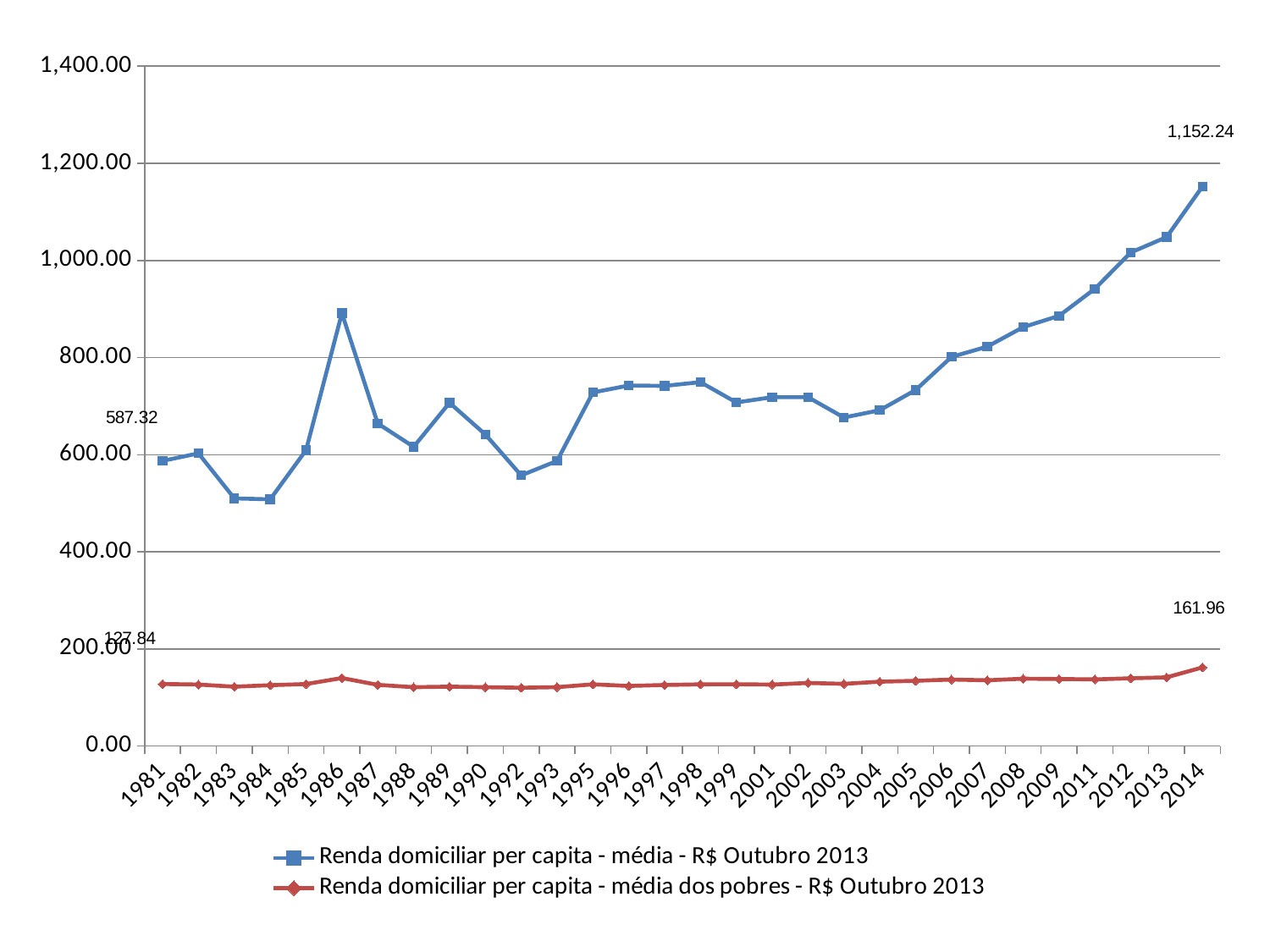
How many series does the legend list? 2 What is the value of the 'Renda domiciliar per capita - média - R$ Outubro 2013' series in 2014? 1,152.24 Which year has the larger value for the 'Renda domiciliar per capita - média - R$ Outubro 2013' series, 1986 or 1987? 1986 What is the value of the 'Renda domiciliar per capita - média - R$ Outubro 2013' series in 1981? 587.32 In which year does the 'Renda domiciliar per capita - média - R$ Outubro 2013' series reach its highest value? 2014 Is the 2003 value of the 'Renda domiciliar per capita - média - R$ Outubro 2013' series greater or less than 800.00? less What kind of chart is shown on the slide? line chart Is the 1986 value of the 'Renda domiciliar per capita - média - R$ Outubro 2013' series greater or less than 800.00? greater What is the difference between the 2014 and 1981 values of the 'Renda domiciliar per capita - média - R$ Outubro 2013' series? 564.92 Is the 1992 value of the 'Renda domiciliar per capita - média - R$ Outubro 2013' series greater or less than 600.00? less Does the 'Renda domiciliar per capita - média - R$ Outubro 2013' series rise or fall from 2004 to 2014? rise What is the value of the 'Renda domiciliar per capita - média dos pobres - R$ Outubro 2013' series in 2014? 161.96